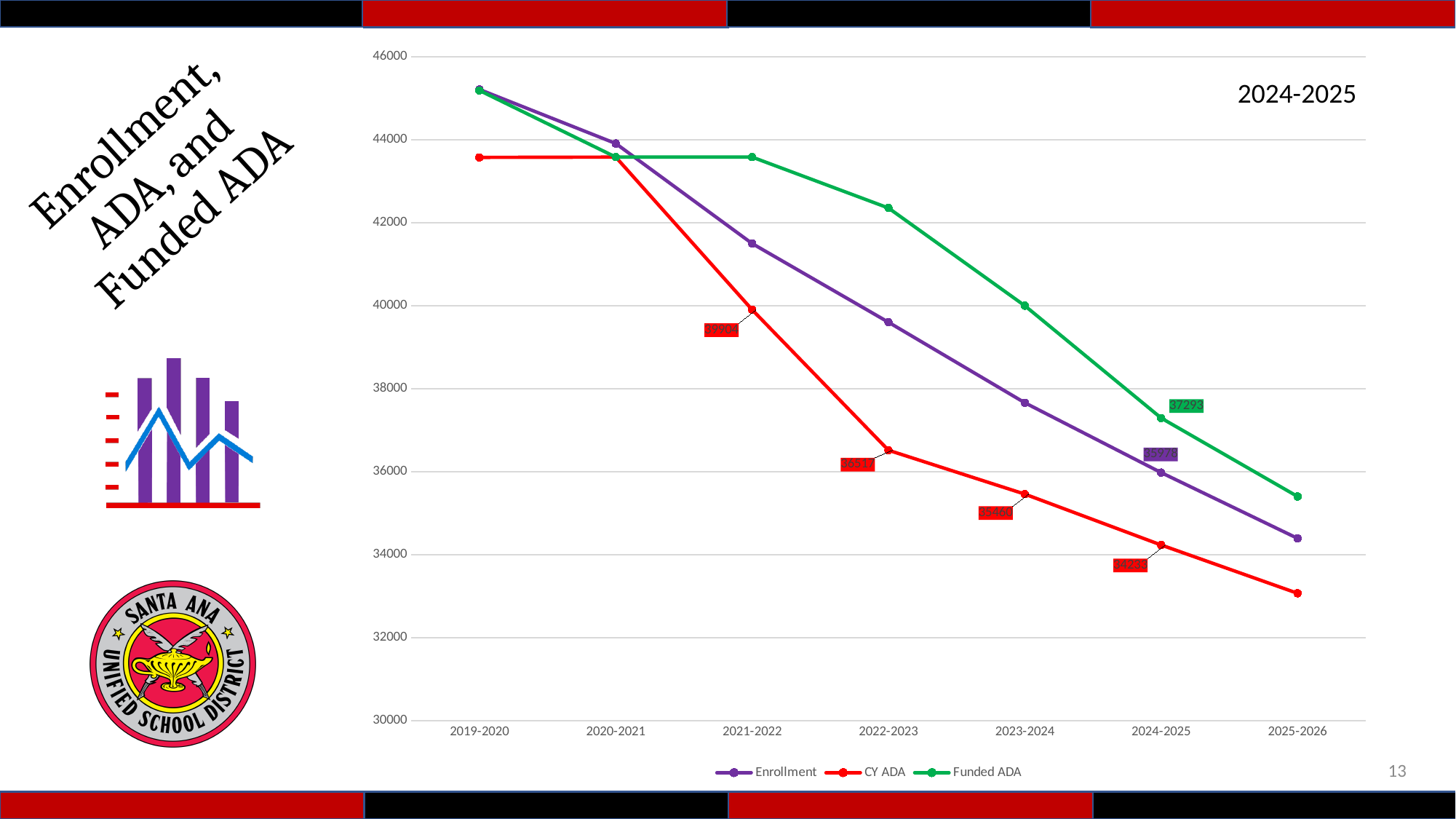
What is the difference between the CY ADA values for 2021-2022 and 2023-2024? 4444 Which series has the lowest value in 2025-2026? CY ADA In 2023-2024, which is larger: Funded ADA or CY ADA? Funded ADA What is the Funded ADA value for 2024-2025? 37293 What kind of chart is shown on the slide? line chart Does the Enrollment series rise or fall from 2019-2020 to 2025-2026? fall How many school years are shown on the x axis? 7 What is the CY ADA value for 2021-2022? 39904 Is the Enrollment value for 2019-2020 greater or less than 44000? greater How many series does the legend list? 3 Which series has the highest value in 2024-2025? Funded ADA What is the CY ADA value for 2023-2024? 35460